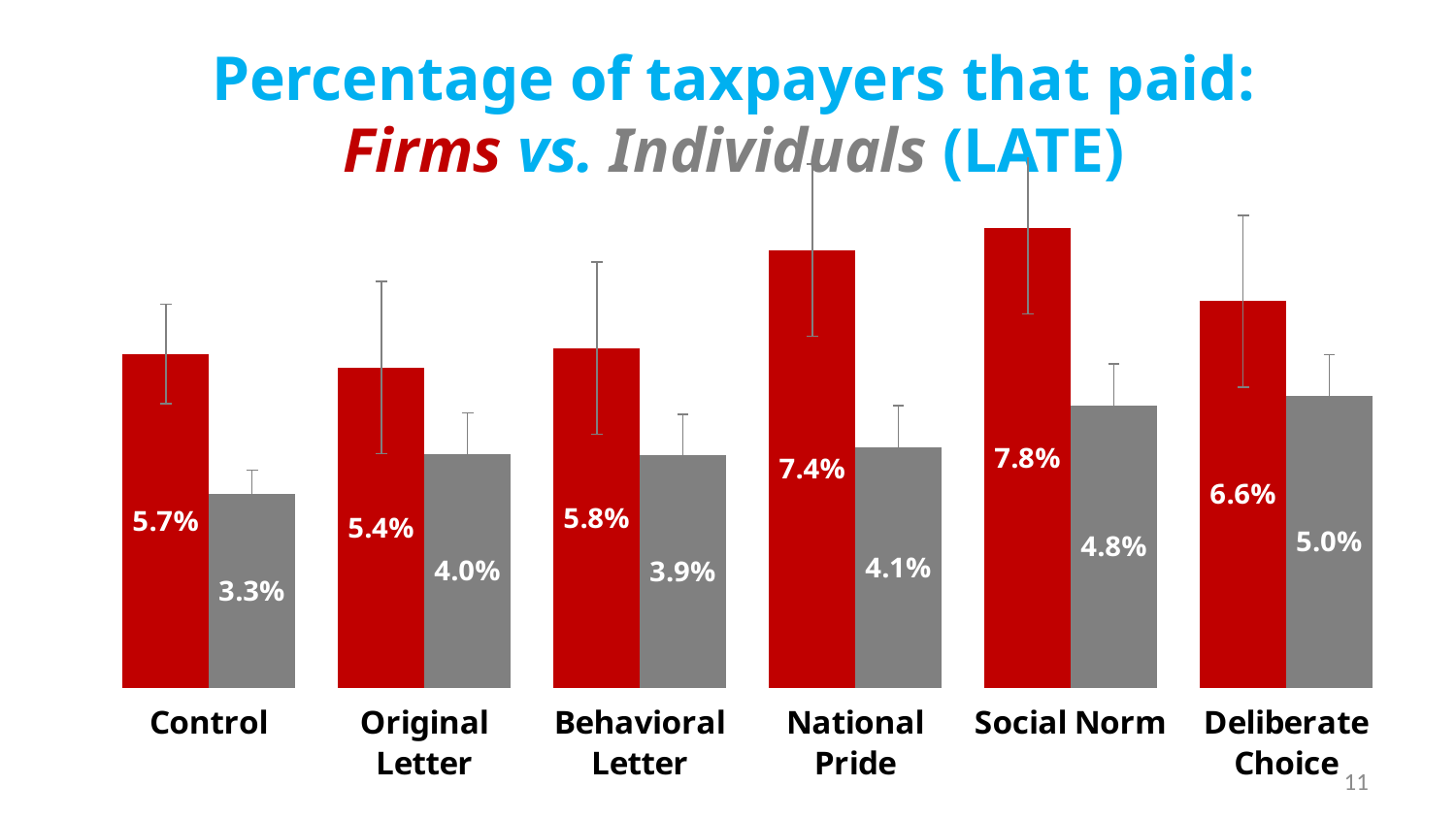
How many conditions are shown on the x axis? 6 What percentage of individuals paid in the Control condition? 3.3% What percentage of firms paid in the Social Norm condition? 7.8% Which condition has the highest percentage of firms that paid? Social Norm Which condition has the lowest percentage of individuals that paid? Control Which condition has the lowest percentage of firms that paid? Original Letter Which colour represents firms in the chart? Red Which is larger: the individuals value for Social Norm or for Deliberate Choice? Deliberate Choice What type of chart is shown on the slide? Bar chart What is the difference between the firms values for Social Norm and Control? 2.1% What is the difference between the firms and individuals values in the National Pride condition? 3.3% What is the value for individuals under Deliberate Choice? 5.0%